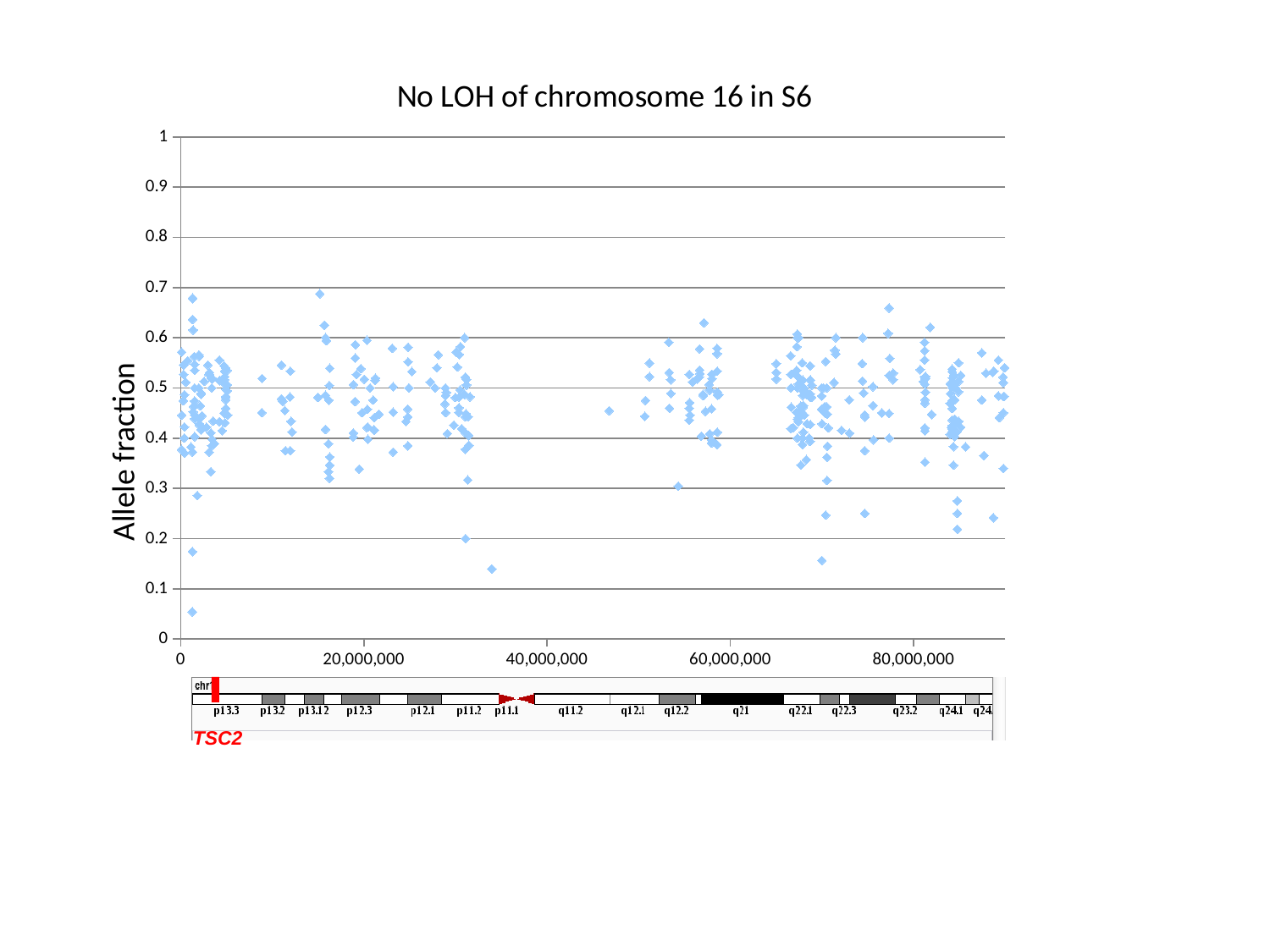
Is the lowest plotted point on the chart greater or less than 0.1? less What is the title of the chart? No LOH of chromosome 16 in S6 What is the label of the y axis? Allele fraction Is the value of the isolated point near 35,000,000 on the x axis greater or less than 0.2? less Is the value of the single point near 46,000,000 on the x axis greater or less than 0.4? greater What kind of chart is shown on the slide? scatter plot Do the plotted allele fraction values show a clear rising or falling trend along the x axis, or stay roughly level? roughly level